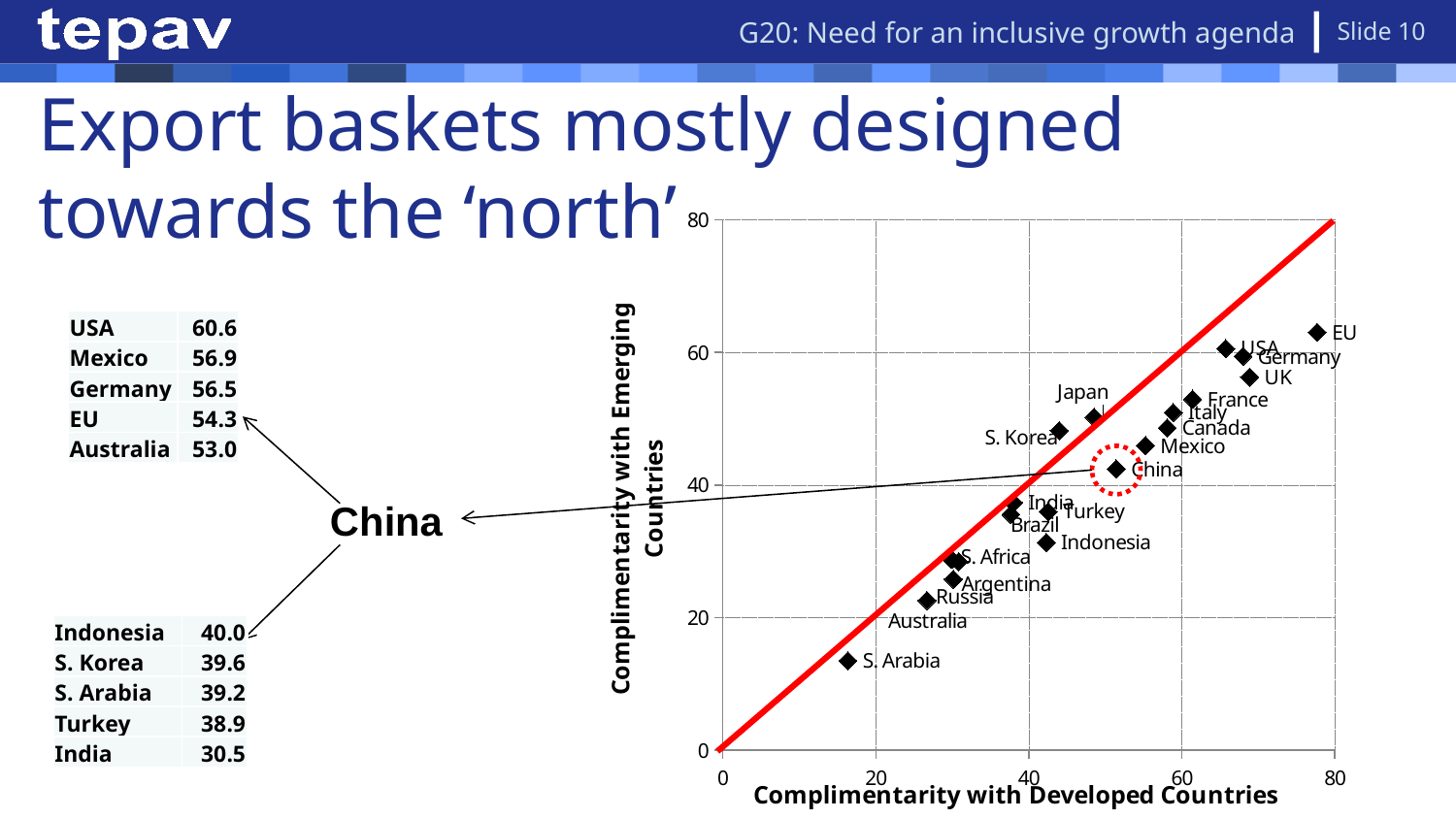
Which country has the highest value on the 'Complimentarity with Developed Countries' axis? EU As 'Complimentarity with Developed Countries' increases along the x axis, do the plotted points generally rise or fall? rise Which country has the lowest value on the 'Complimentarity with Emerging Countries' axis? S. Arabia Is the 'Complimentarity with Developed Countries' value for EU greater or less than 60? greater How many country points are plotted on the scatter chart? 20 Which has a higher 'Complimentarity with Emerging Countries' value, Japan or Indonesia? Japan Is the 'Complimentarity with Developed Countries' value for Japan greater or less than 60? less Which has a higher 'Complimentarity with Developed Countries' value, S. Arabia or Germany? Germany Is the 'Complimentarity with Emerging Countries' value for S. Arabia greater or less than 20? less What kind of chart is shown on the slide? scatter chart What is the title of the vertical axis of the scatter chart? Complimentarity with Emerging Countries